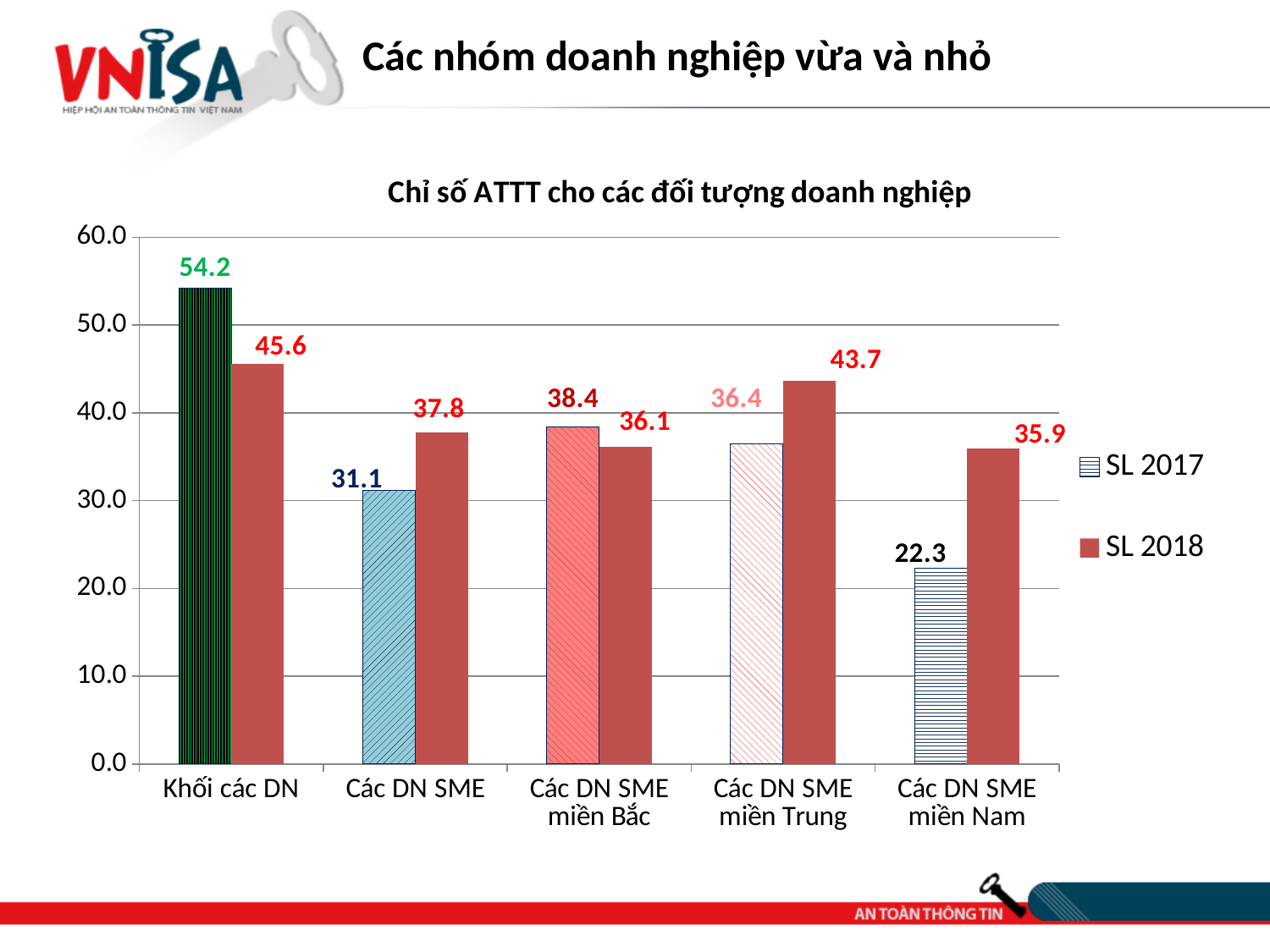
What is the title of the chart? Chỉ số ATTT cho các đối tượng doanh nghiệp What is the difference between the SL 2018 and SL 2017 values for Các DN SME miền Nam? 13.6 What is the SL 2017 value for Các DN SME miền Nam? 22.3 Which is larger for Các DN SME miền Bắc, the SL 2017 value or the SL 2018 value? SL 2017 Is the SL 2018 value for Các DN SME greater or less than 40.0? less Which category has the lowest SL 2017 value? Các DN SME miền Nam What is the SL 2018 value for Các DN SME miền Trung? 43.7 What kind of chart is shown on the slide? bar chart Which category has the highest SL 2018 value? Khối các DN What is the SL 2017 value for Khối các DN? 54.2 How many series does the legend list? 2 How many categories are shown on the x axis? 5